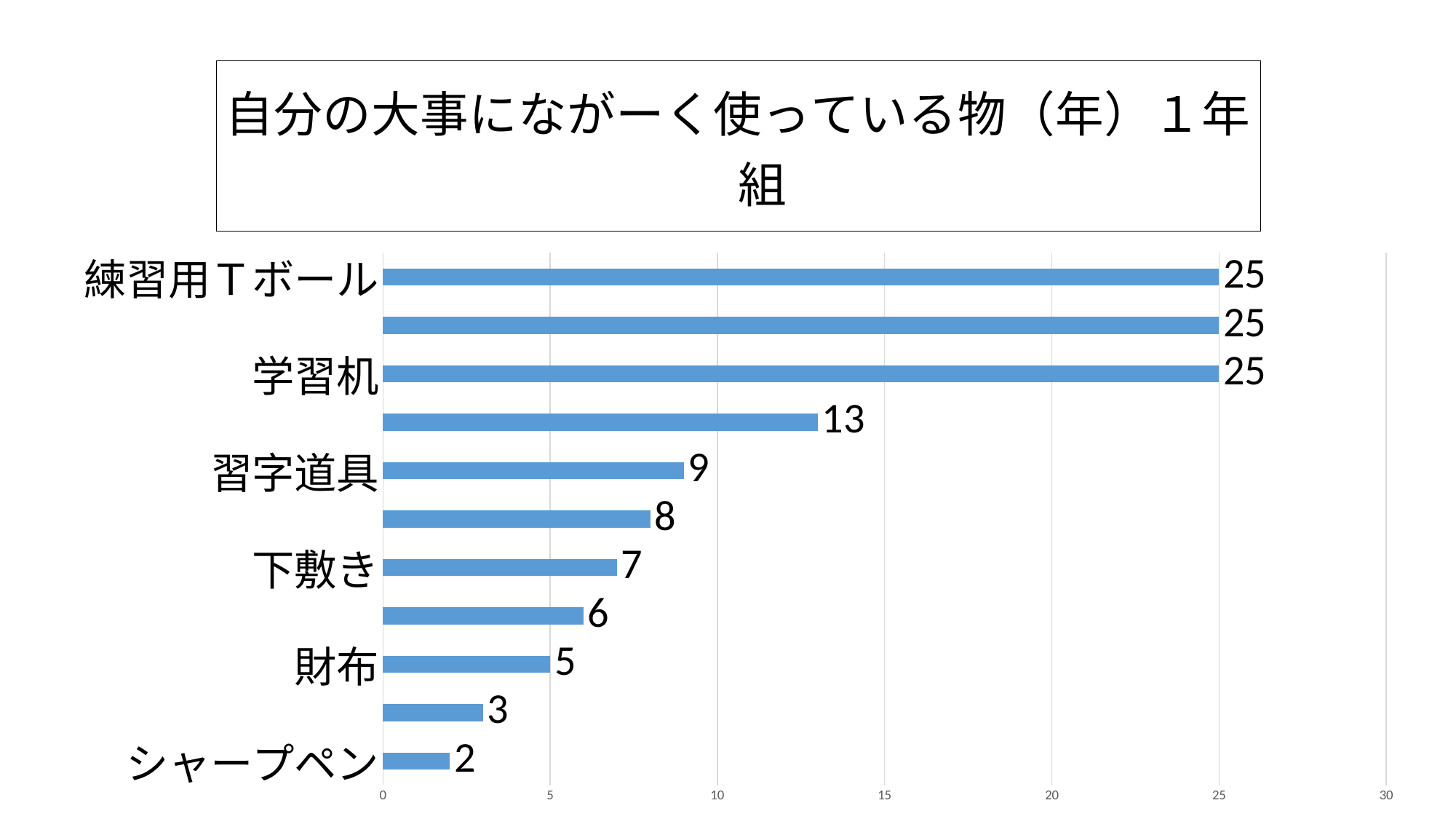
What is the difference between the values for 習字道具 and 財布? 4 Which is larger, the value for 下敷き or the value for シャープペン? 下敷き What type of chart is shown on the slide? bar chart Which category has the lowest value? シャープペン What is the highest value shown in the chart? 25 What is the value for 学習机? 25 What is the value for シャープペン? 2 What is the value for 財布? 5 What is the value for 習字道具? 9 What is the value for 下敷き? 7 What is the value for 練習用Ｔボール? 25 How many bars are plotted in the chart? 11